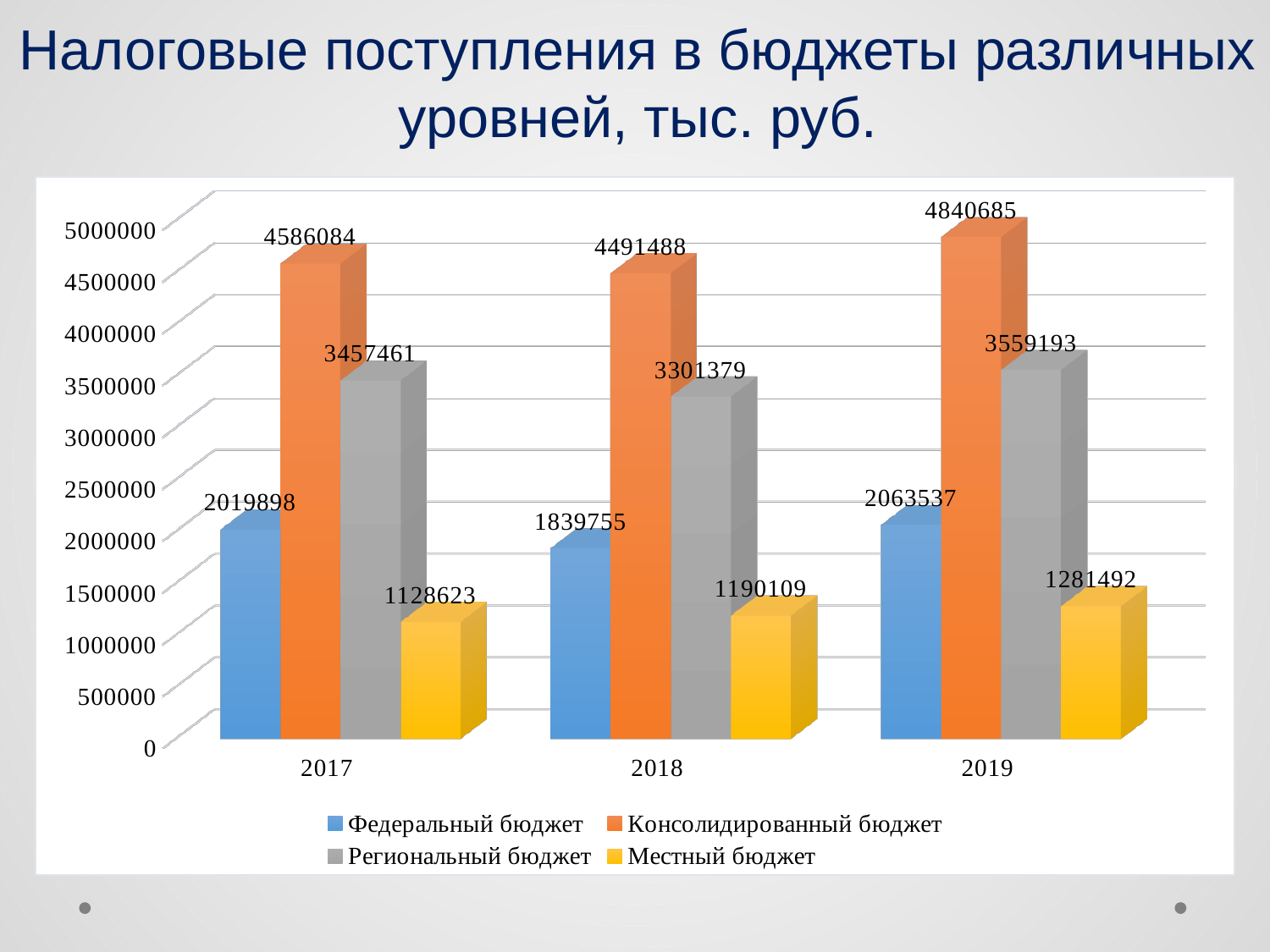
Which is larger: Региональный бюджет in 2017 or Региональный бюджет in 2019? Региональный бюджет in 2019 What is the value for Федеральный бюджет in 2018? 1839755 What is the difference between Местный бюджет in 2019 and in 2018? 91383 What is the value for Консолидированный бюджет in 2019? 4840685 What kind of chart is shown on the slide? Bar chart What is the difference between Консолидированный бюджет in 2019 and in 2017? 254601 What is the value for Региональный бюджет in 2018? 3301379 What is the value for Местный бюджет in 2017? 1128623 How many series does the legend list? 4 In which year is Консолидированный бюджет highest? 2019 Do the values for Местный бюджет rise or fall from 2017 to 2019? Rise In which year is Федеральный бюджет lowest? 2018